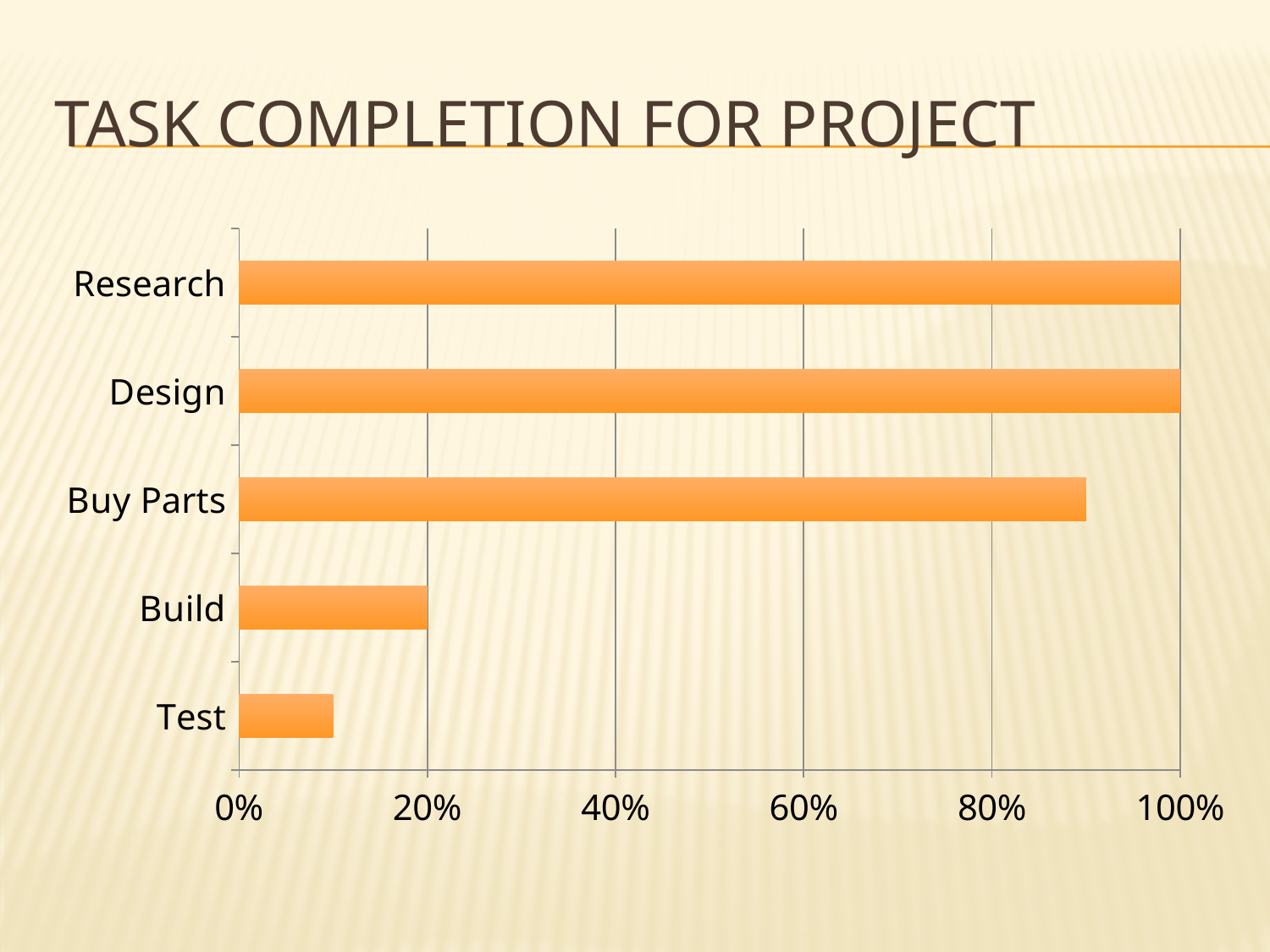
What is the title of the slide? Task Completion for Project Is the value for Test greater or less than 20%? less Is the value for Buy Parts greater or less than 80%? greater What is the completion value for Research? 100% What is the completion value for Design? 100% What is the completion value for Build? 20% What kind of chart is shown on the slide? Bar chart Which has a larger value, Buy Parts or Build? Buy Parts What is the difference between the values for Research and Build? 80% Which task has the lowest completion value? Test Which has a larger value, Build or Test? Build How many tasks are shown in the chart? 5